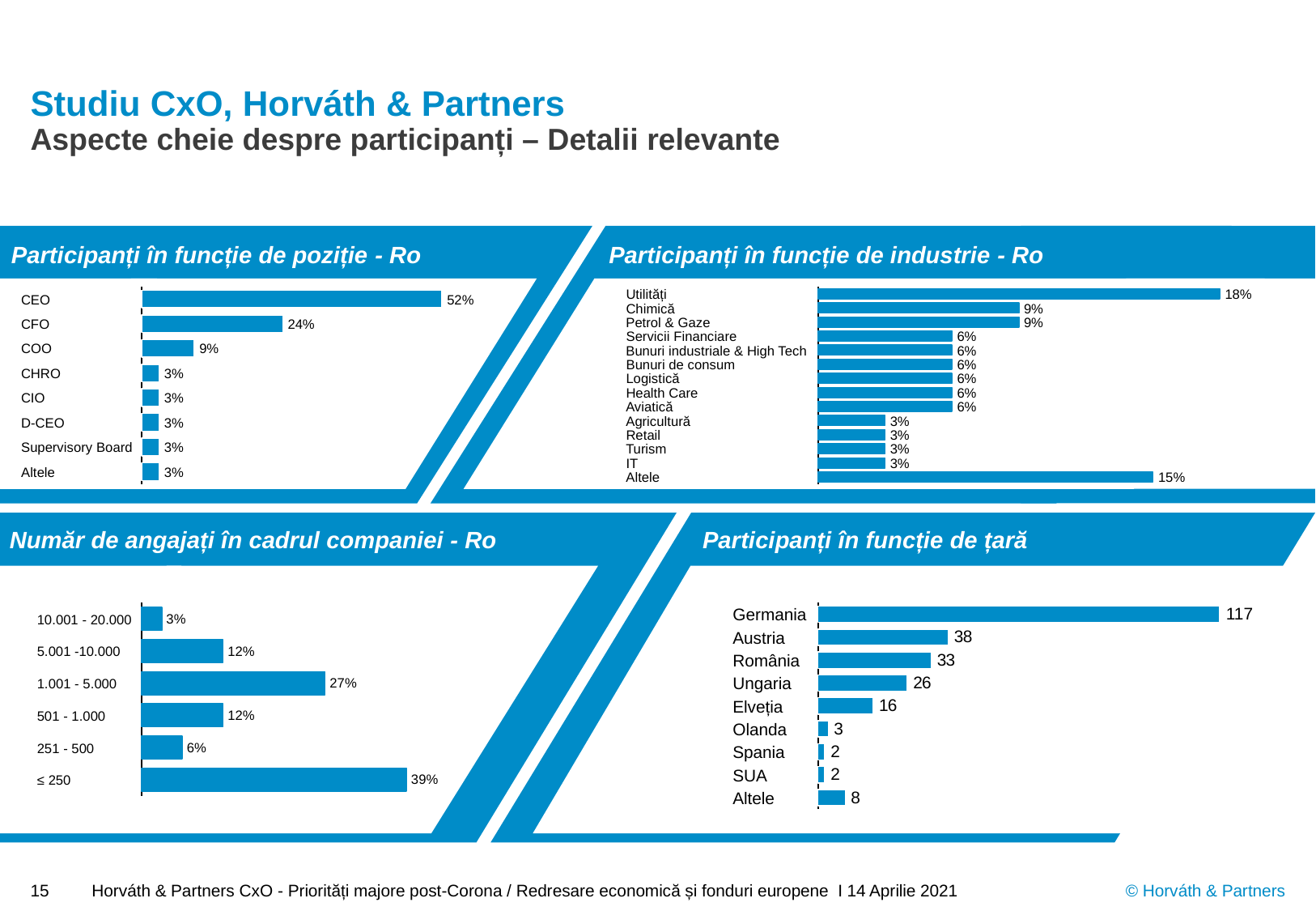
In the chart 'Participanți în funcție de poziție - Ro', what is the difference between the CEO and CFO values? 28% In the chart 'Număr de angajați în cadrul companiei - Ro', what is the value for 1.001 - 5.000? 27% In the chart 'Participanți în funcție de poziție - Ro', what is the value for CEO? 52% What type of chart is 'Participanți în funcție de țară'? Bar chart In the chart 'Participanți în funcție de țară', what is the value for Germania? 117 In the chart 'Număr de angajați în cadrul companiei - Ro', which is larger: 251 - 500 or 5.001 -10.000? 5.001 -10.000 In the chart 'Participanți în funcție de industrie - Ro', what is the value for Altele? 15% In the chart 'Participanți în funcție de industrie - Ro', which industry has the highest value? Utilități In the chart 'Participanți în funcție de industrie - Ro', how many categories are shown? 14 In the chart 'Număr de angajați în cadrul companiei - Ro', which category has the highest value? ≤ 250 In the chart 'Participanți în funcție de poziție - Ro', how many categories are shown? 8 In the chart 'Participanți în funcție de țară', what is the difference between Austria and România? 5